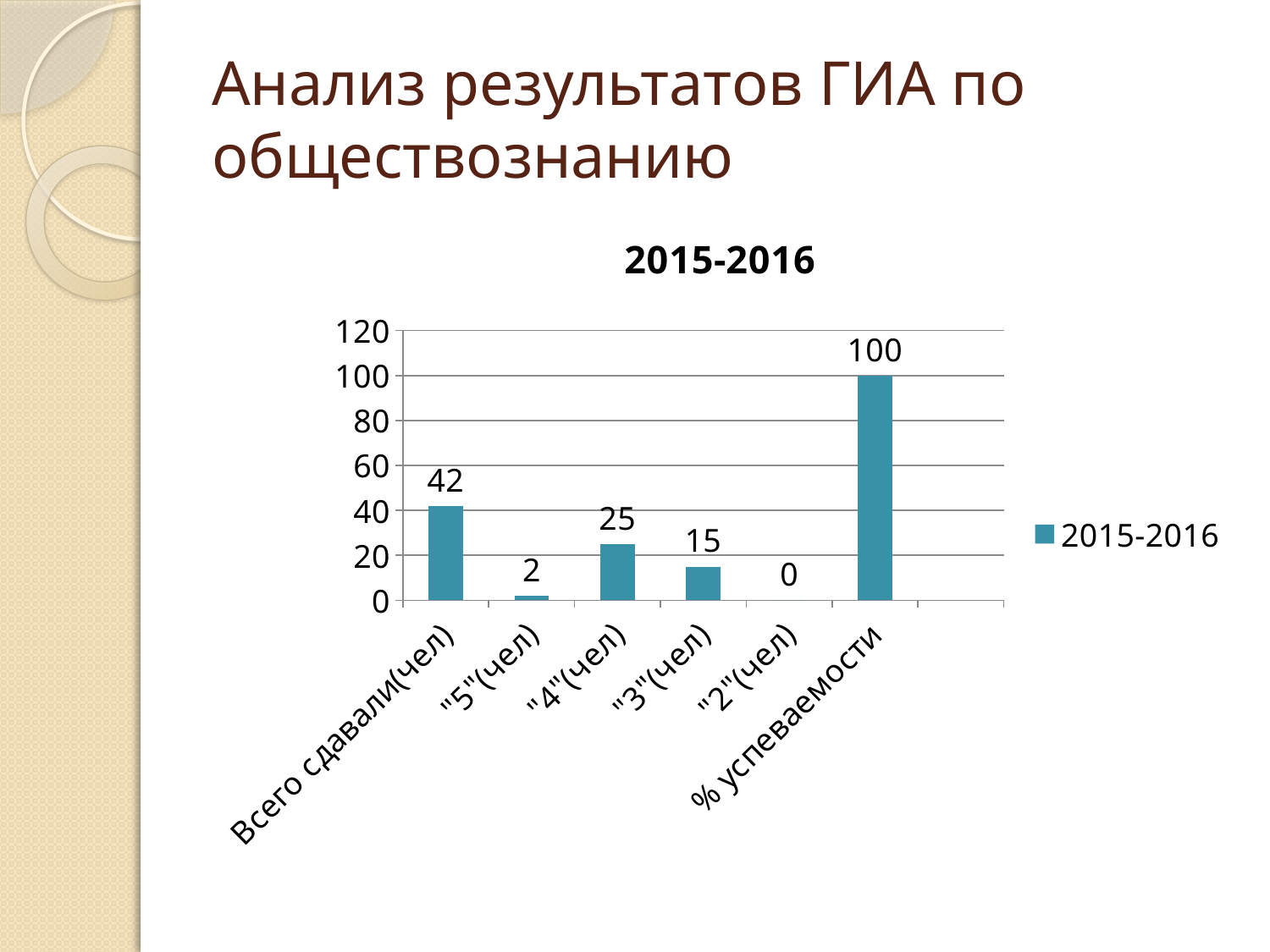
What is the value for ""2"(чел)"? 0 What kind of chart is shown on the slide? bar chart Which category has the highest value? % успеваемости Is the value for "Всего сдавали(чел)" greater or less than 60? less What is the difference between the values for ""4"(чел)" and ""3"(чел)"? 10 What is the value for "Всего сдавали(чел)"? 42 Which is larger, the value for ""5"(чел)" or the value for ""3"(чел)"? "3"(чел) Which category has the lowest value? "2"(чел) What is the value for ""4"(чел)"? 25 How many categories are shown on the x axis? 6 What is the value for "% успеваемости"? 100 How many series does the legend list? 1